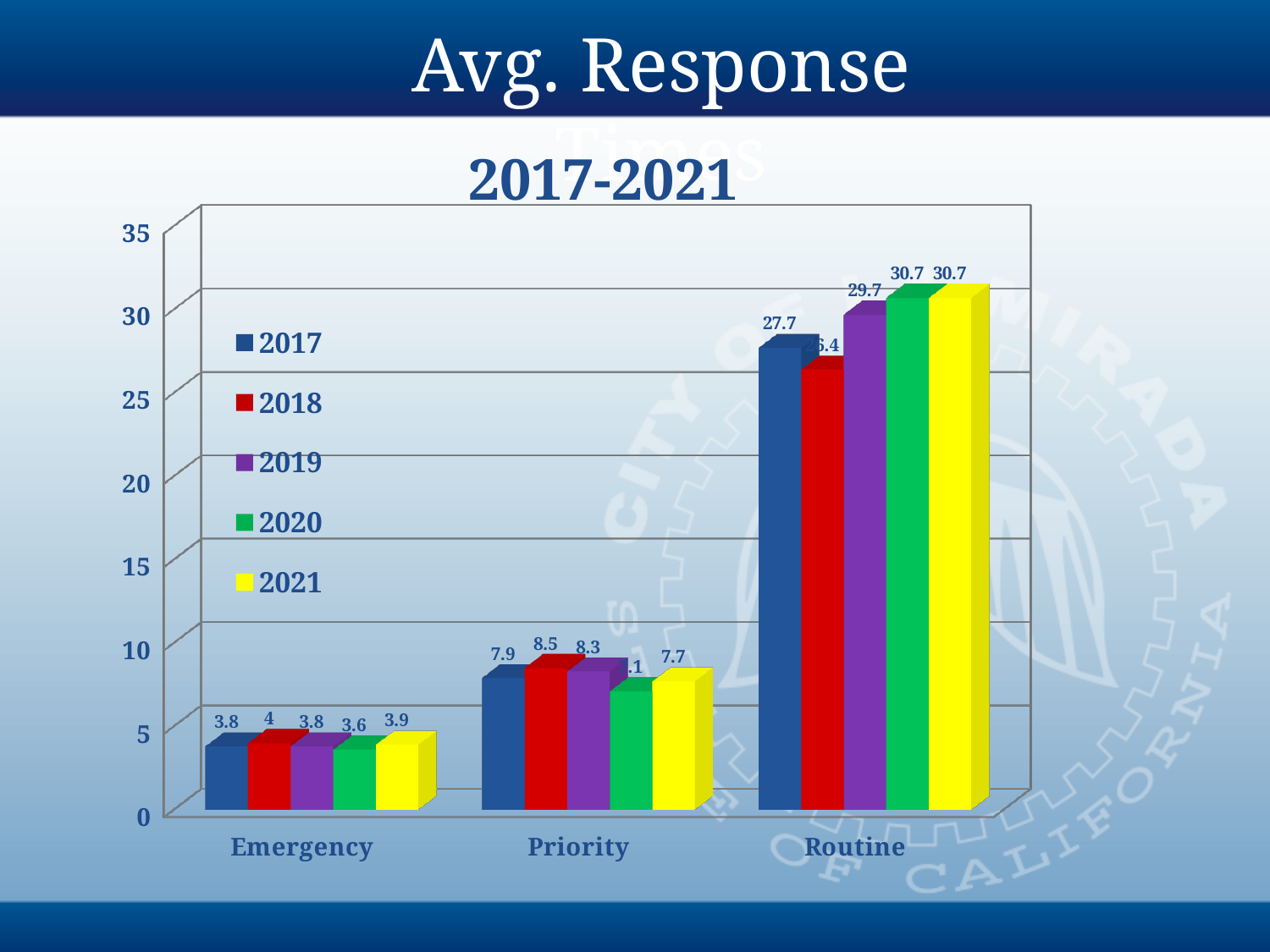
What is the difference between the 2021 and 2017 values in the Routine category? 3 Which colour represents 2021 in the legend? yellow How many series does the legend list? 5 Is the value for 2020 in the Priority category greater or less than 10? less What kind of chart is shown on the slide? bar chart What is the value for 2018 in the Emergency category? 4 Which is larger in the Priority category, the 2017 value or the 2019 value? 2019 What is the value for 2019 in the Routine category? 29.7 How many categories are shown on the x axis? 3 Which year has the highest value in the Priority category? 2018 What is the value for 2021 in the Priority category? 7.7 Which year has the lowest value in the Emergency category? 2020